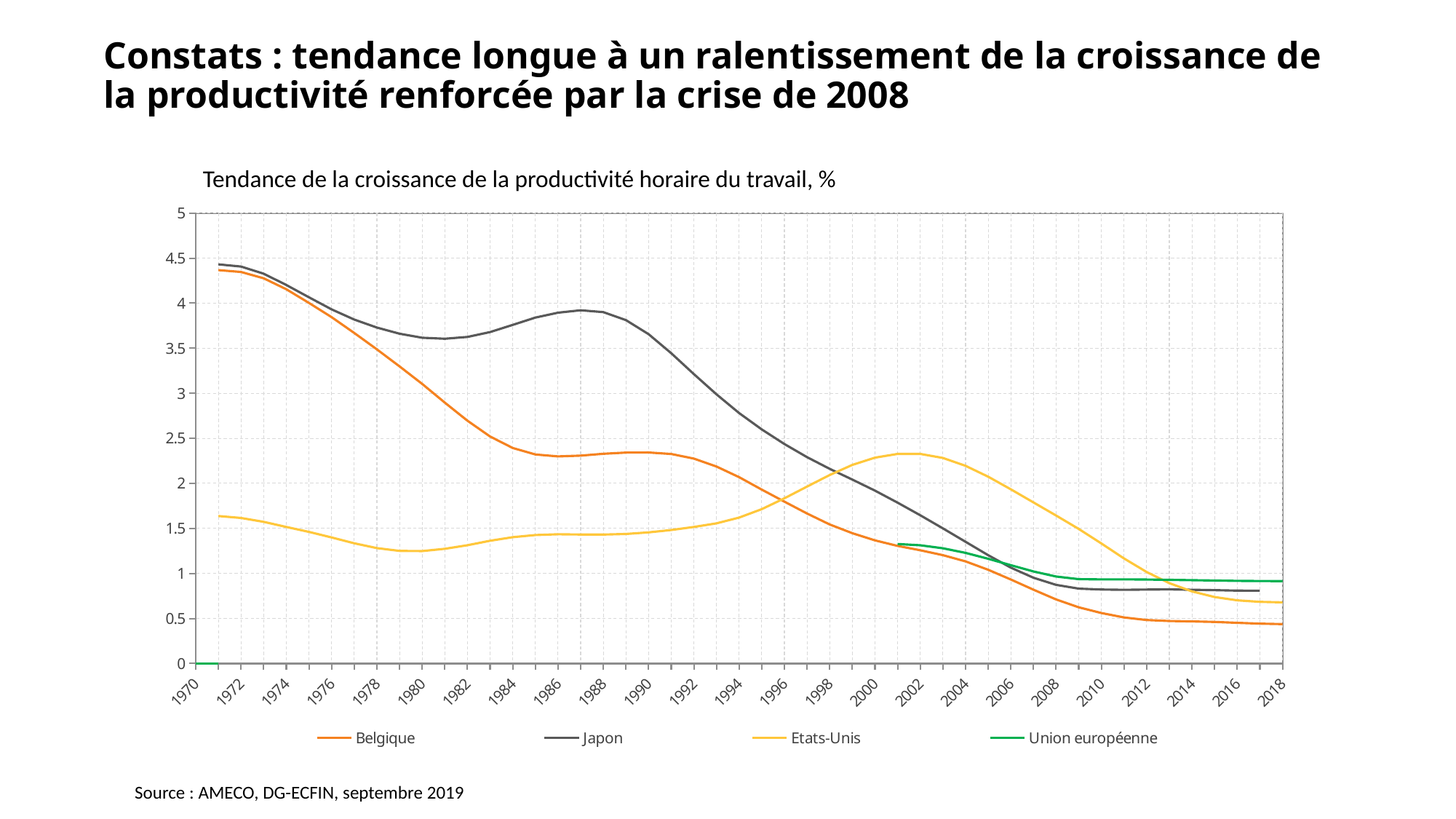
What kind of chart is shown on the slide? line chart What is the title of the chart? Tendance de la croissance de la productivité horaire du travail, % In 1980, which series has the higher value, Japon or Belgique? Japon Does the Etats-Unis line rise or fall between 1990 and 2002? rise Does the Belgique line rise or fall overall from 1970 to 2018? fall Which series are listed in the chart legend? Belgique, Japon, Etats-Unis, Union européenne In 2002, which series has the higher value, Etats-Unis or Belgique? Etats-Unis How many series does the legend of the chart list? 4 Is the value for Union européenne in 2018 greater or less than 0.5? greater Is the value for Japon in 2016 greater or less than 1? less Is the value for Belgique in 1972 greater or less than 4? greater